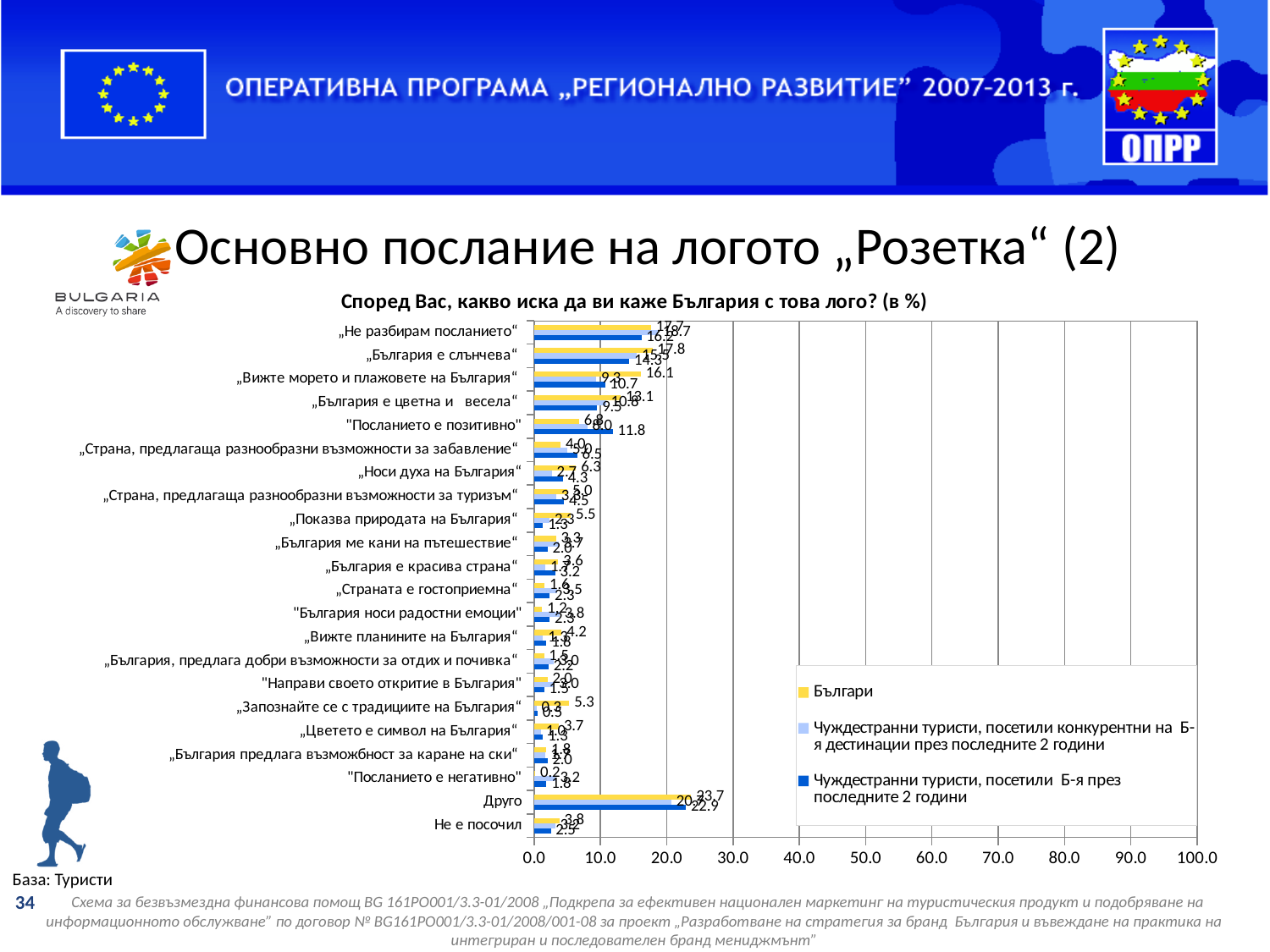
What is the value for „Показва природата на България“ for the series „Чуждестранни туристи, посетили конкурентни на Б-я дестинации през последните 2 години“? 2.3 What is the title of the chart? Според Вас, какво иска да ви каже България с това лого? (в %) For „Вижте морето и плажовете на България“, which is larger: the value for „Българи“ or the value for „Чуждестранни туристи, посетили конкурентни на Б-я дестинации през последните 2 години“? Българи What is the value for "Посланието е позитивно" for the series „Чуждестранни туристи, посетили Б-я през последните 2 години“? 11.8 Is the value for „Друго“ for the series „Чуждестранни туристи, посетили Б-я през последните 2 години“ greater or less than 20.0? greater What kind of chart is shown on the slide? bar chart What is the value for „Друго“ for the series „Чуждестранни туристи, посетили конкурентни на Б-я дестинации през последните 2 години“? 20.7 Which colour represents the series „Българи“ in the chart? yellow How many series does the chart legend list? 3 Which category has the highest value for the series „Чуждестранни туристи, посетили Б-я през последните 2 години“? Друго How many categories (response options) are plotted on the chart? 22 What is the value for „Вижте морето и плажовете на България“ for the series „Чуждестранни туристи, посетили конкурентни на Б-я дестинации през последните 2 години“? 9.3